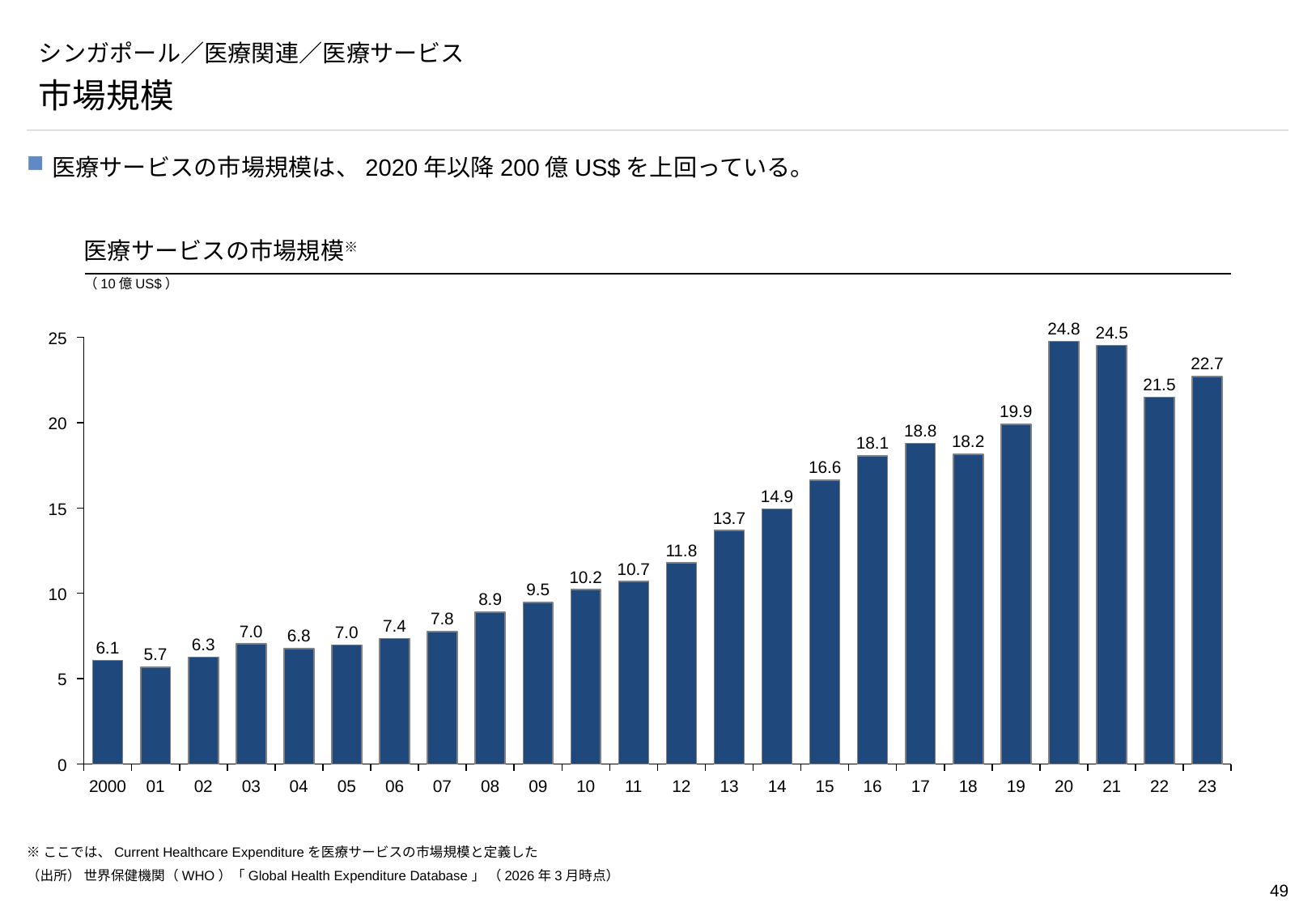
What kind of chart is shown on the slide? Bar chart What is the difference between the values for 2021 and 2022? 3.0 What is the value for 2023 in the chart? 22.7 What is the value for 2020 in the chart? 24.8 Which is larger, the value for 2017 or the value for 2018? 2017 Which year has the highest value in the chart? 20 Is the value for 2015 greater or less than 15? greater Do the values generally rise or fall from 2000 to 2020? Rise Which year has the lowest value in the chart? 01 How many years are shown on the x axis of the chart? 24 What unit is shown for the chart's values? 10億US$ What is the value for 2010 in the chart? 10.2